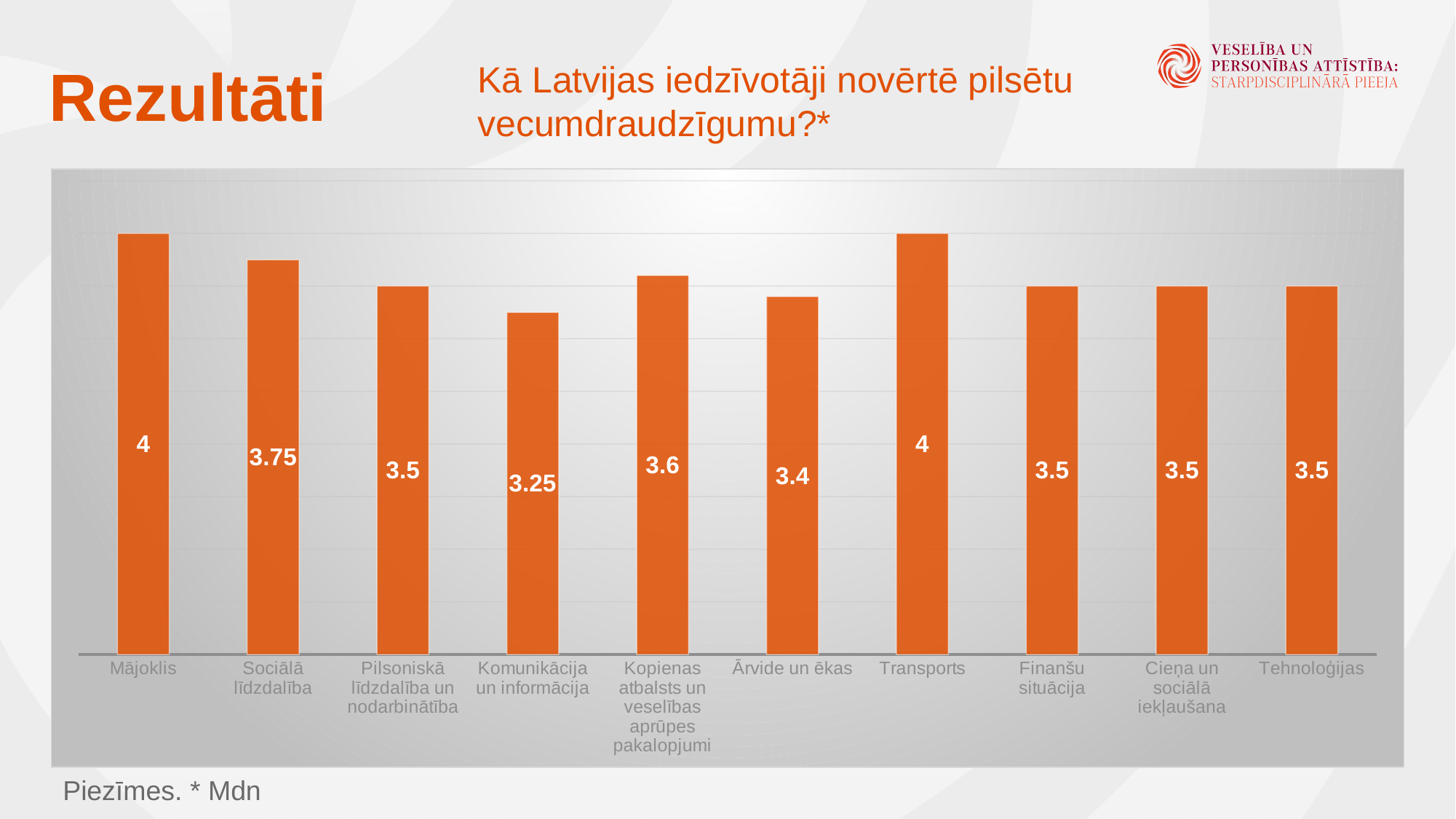
What kind of chart is shown on the slide? Bar chart What is the value for Sociālā līdzdalība? 3.75 How many categories are shown in the chart? 10 What is the difference between the values for Sociālā līdzdalība and Komunikācija un informācija? 0.5 Which is larger, the value for Kopienas atbalsts un veselības aprūpes pakalpojumi or the value for Ārvide un ēkas? Kopienas atbalsts un veselības aprūpes pakalpojumi What is the value for Komunikācija un informācija? 3.25 What is the value for Kopienas atbalsts un veselības aprūpes pakalpojumi? 3.6 What is the value for Ārvide un ēkas? 3.4 How many categories have a value of 3.5? 4 Which two categories share the highest value? Mājoklis and Transports Which category has the lowest value? Komunikācija un informācija What is the value for Mājoklis? 4